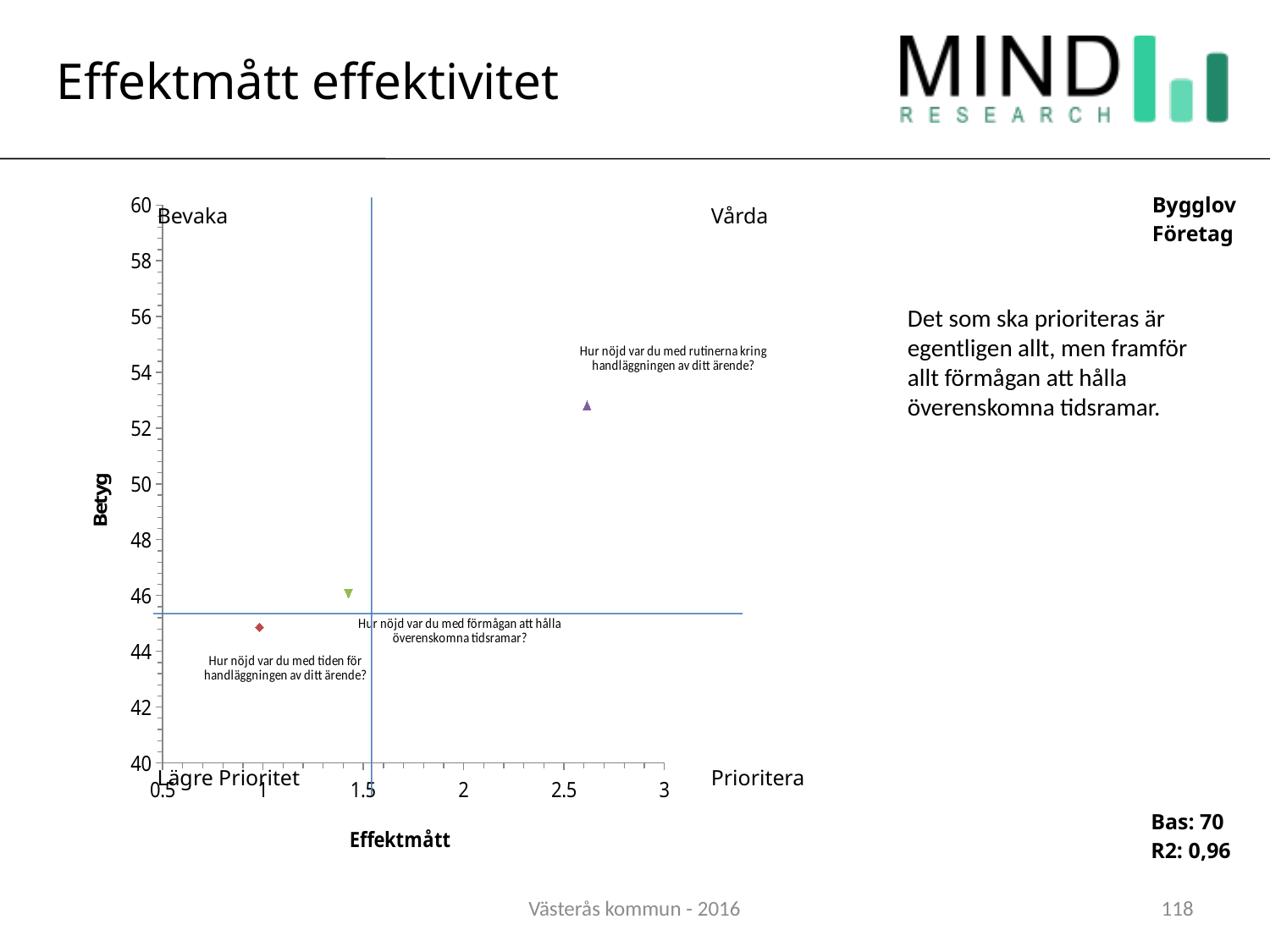
What kind of chart is shown on the slide? scatter chart Which question has the highest Effektmått value in the chart? Hur nöjd var du med rutinerna kring handläggningen av ditt ärende? Is the Betyg value for "Hur nöjd var du med tiden för handläggningen av ditt ärende?" greater or less than 46? less Which question has the lowest Betyg value in the chart? Hur nöjd var du med tiden för handläggningen av ditt ärende? How many data points are plotted in the chart? 3 Which has a higher Betyg value: "Hur nöjd var du med förmågan att hålla överenskomna tidsramar?" or "Hur nöjd var du med tiden för handläggningen av ditt ärende?" Hur nöjd var du med förmågan att hålla överenskomna tidsramar? Is the Effektmått value for "Hur nöjd var du med förmågan att hålla överenskomna tidsramar?" greater or less than 1.5? less Is the Effektmått value for "Hur nöjd var du med rutinerna kring handläggningen av ditt ärende?" greater or less than 2.5? greater Which question has the highest Betyg value in the chart? Hur nöjd var du med rutinerna kring handläggningen av ditt ärende? What is the title of the x axis of the chart? Effektmått What is the title of the y axis of the chart? Betyg